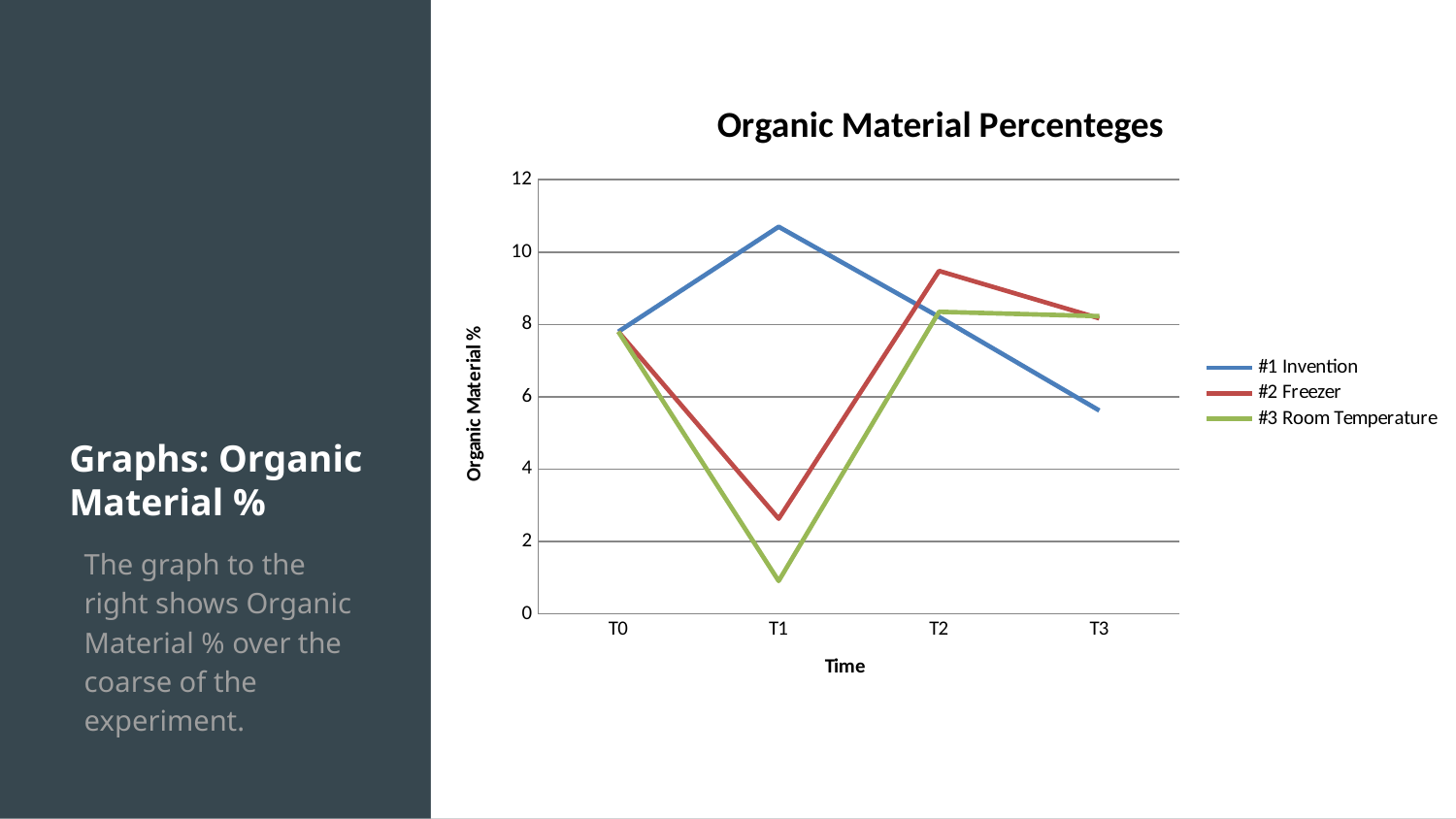
Is the value for #3 Room Temperature at T1 greater or less than 2? less Is the value for #1 Invention at T3 greater or less than 6? less What kind of chart is shown on the slide? line chart How many series does the legend list? 3 Is the value for #1 Invention at T1 greater or less than 10? greater What is the title of the chart? Organic Material Percenteges Which series has the lowest value at T1? #3 Room Temperature Which series has the highest value at T1? #1 Invention At T2, which is larger: the value for #2 Freezer or the value for #1 Invention? #2 Freezer What is the label of the vertical axis? Organic Material % How many time points are shown on the x axis? 4